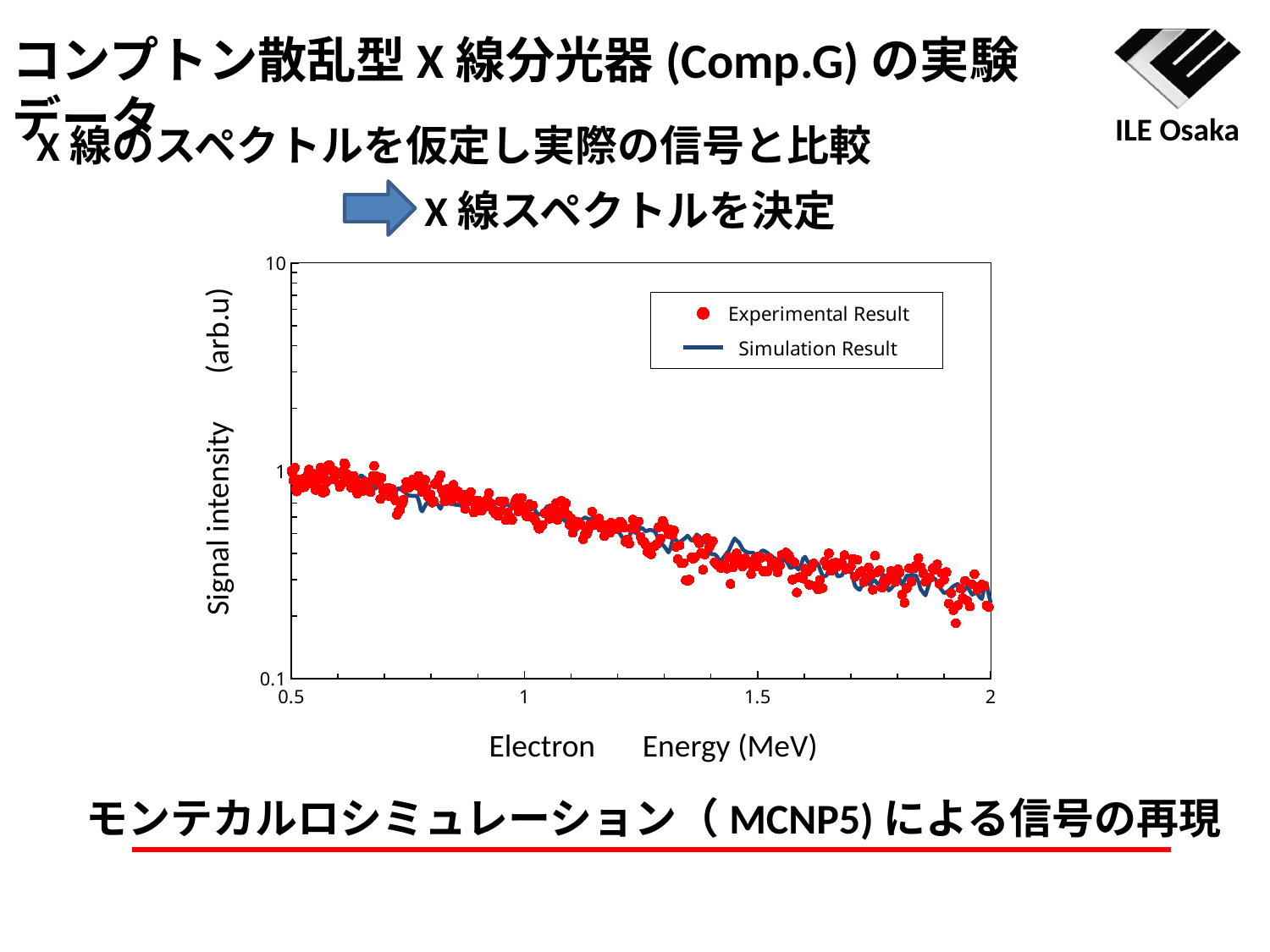
What is the maximum value shown on the y axis of the chart? 10 What are the two series named in the chart legend? Experimental Result and Simulation Result Is the Simulation Result signal intensity at 1.5 MeV greater or less than 1? less Does the signal intensity rise or fall as electron energy increases from 0.5 to 2 MeV? Fall Is the Experimental Result signal intensity at 2 MeV greater or less than 1? less What kind of chart is shown on the slide? Scatter plot with a line (scatter/line chart) How many series does the legend list in the chart? 2 Which series is larger at 0.5 MeV compared with 2 MeV for the Experimental Result: the value at 0.5 MeV or the value at 2 MeV? The value at 0.5 MeV What is the label of the x axis of the chart? Electron Energy (MeV) Is the Experimental Result signal intensity at 2 MeV greater or less than 0.1? greater What is the minimum value shown on the x axis of the chart? 0.5